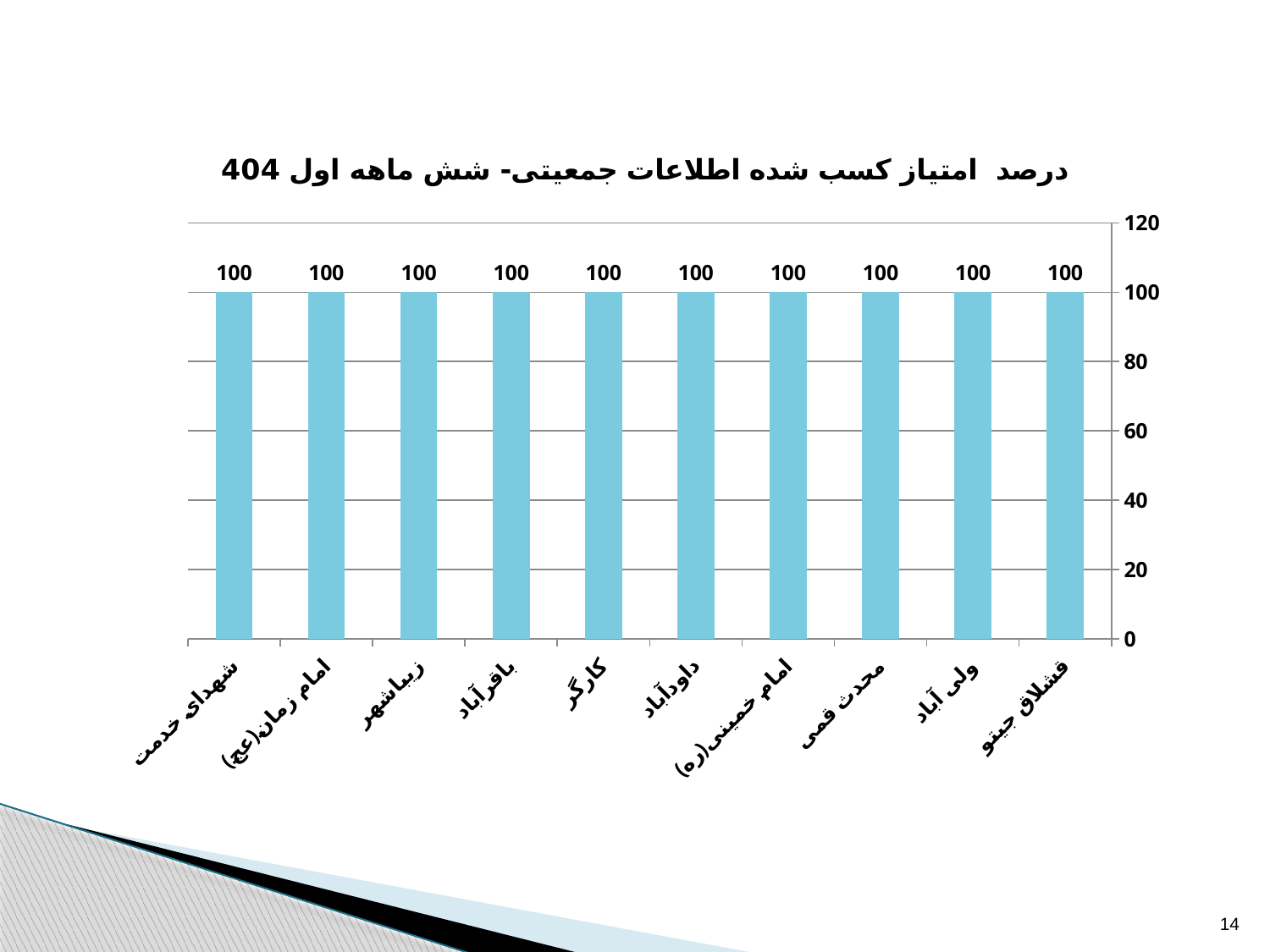
What is the title of the chart? درصد امتیاز کسب شده اطلاعات جمعیتی- شش ماهه اول 404 Do the values rise, fall, or stay flat across the categories along the x axis? stay flat How many categories are shown on the x axis? 10 What is the value for زیباشهر? 100 What is the highest value shown on the vertical axis? 120 What is the value for کارگر? 100 What is the value for امام خمینی(ره)? 100 What is the difference between the values for باقرآباد and داودآباد? 0 Is the value for محدث قمی greater or less than 80? greater What is the value for قشلاق جیتو? 100 Is the value for ولی آباد greater or less than 120? less What kind of chart is shown on the slide? bar chart